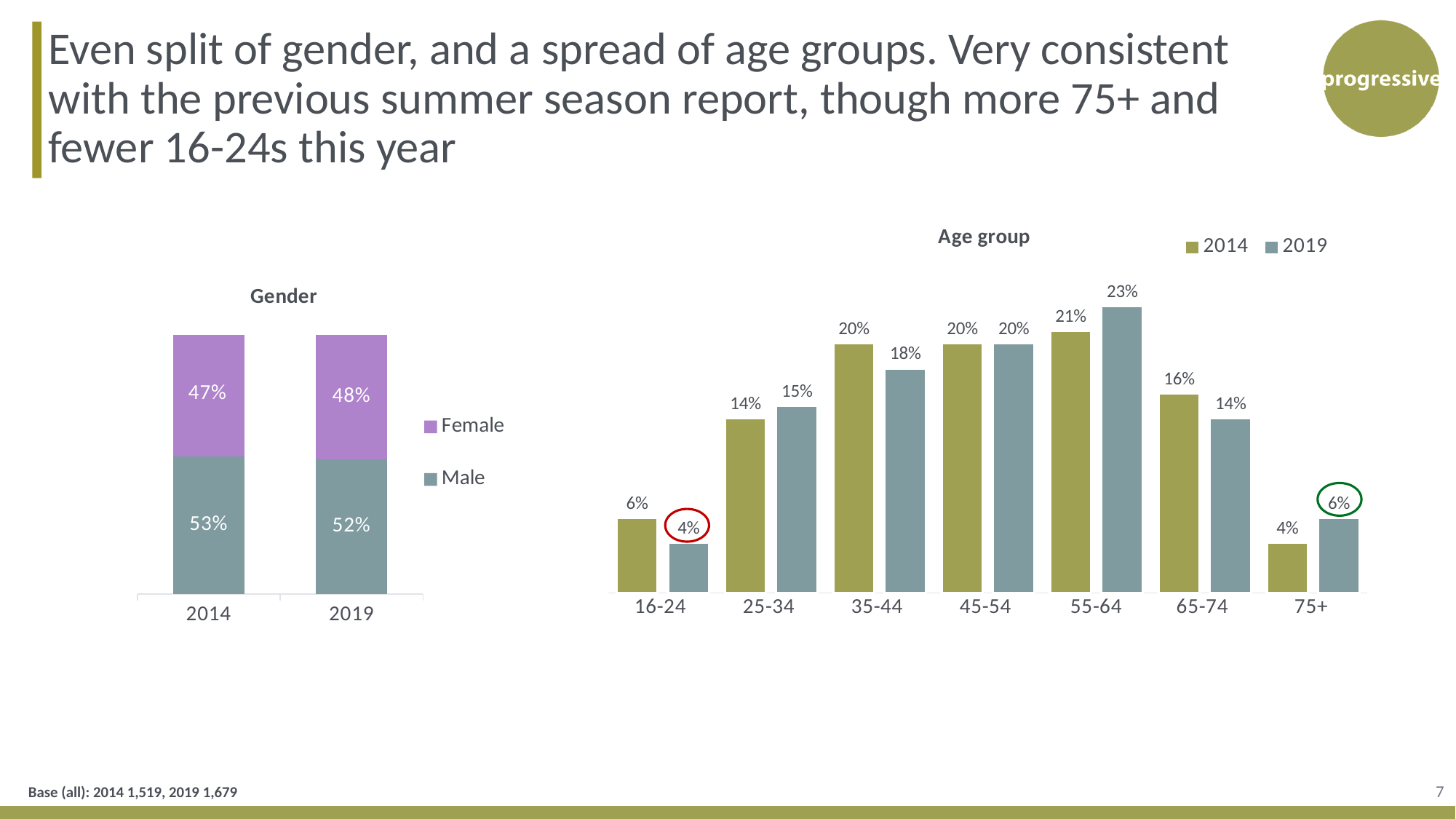
In the Age group chart, which age group has the lowest value for 2014? 75+ In the Gender chart, what percentage of respondents were Male in 2014? 53% In the Gender chart, what percentage of respondents were Female in 2019? 48% In the Age group chart, how many age group categories are shown? 7 In the Age group chart, which age group has the highest value for 2019? 55-64 In the Gender chart, what is the total of the stacked bar for 2014? 100% In the Age group chart, what is the difference between the 2014 and 2019 values for 65-74? 2% What kind of chart is the Age group chart? Bar chart In the Age group chart, which is larger for 35-44: the 2014 value or the 2019 value? 2014 In the Age group chart, what is the value for 55-64 in 2019? 23% In the Gender chart, how many series does the legend list? 2 In the Age group chart, what is the value for 16-24 in 2019? 4%